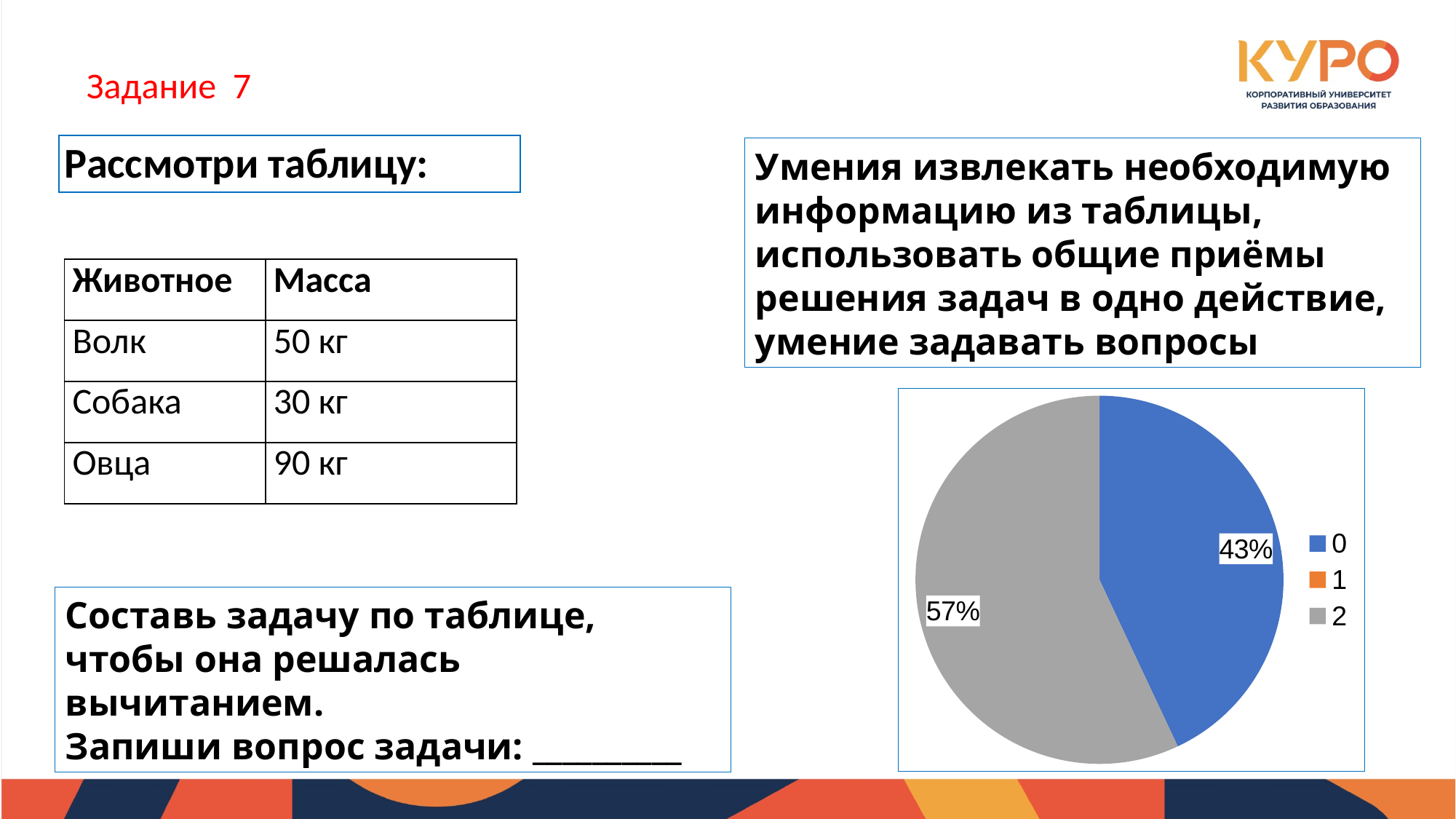
Which of the two labelled slices is larger, category 0 or category 2? 2 How many entries does the legend of the pie chart list? 3 How many slices with percentage labels are visible in the pie chart? 2 What share of the pie does category 0 take? 43% What share of the pie does category 2 take? 57% Which category has the largest slice of the pie? 2 What colour is the slice for category 0 in the pie chart? blue What is the difference between the shares of category 2 and category 0? 14% What kind of chart is shown on the slide? pie chart What colour is the slice for category 2 in the pie chart? gray